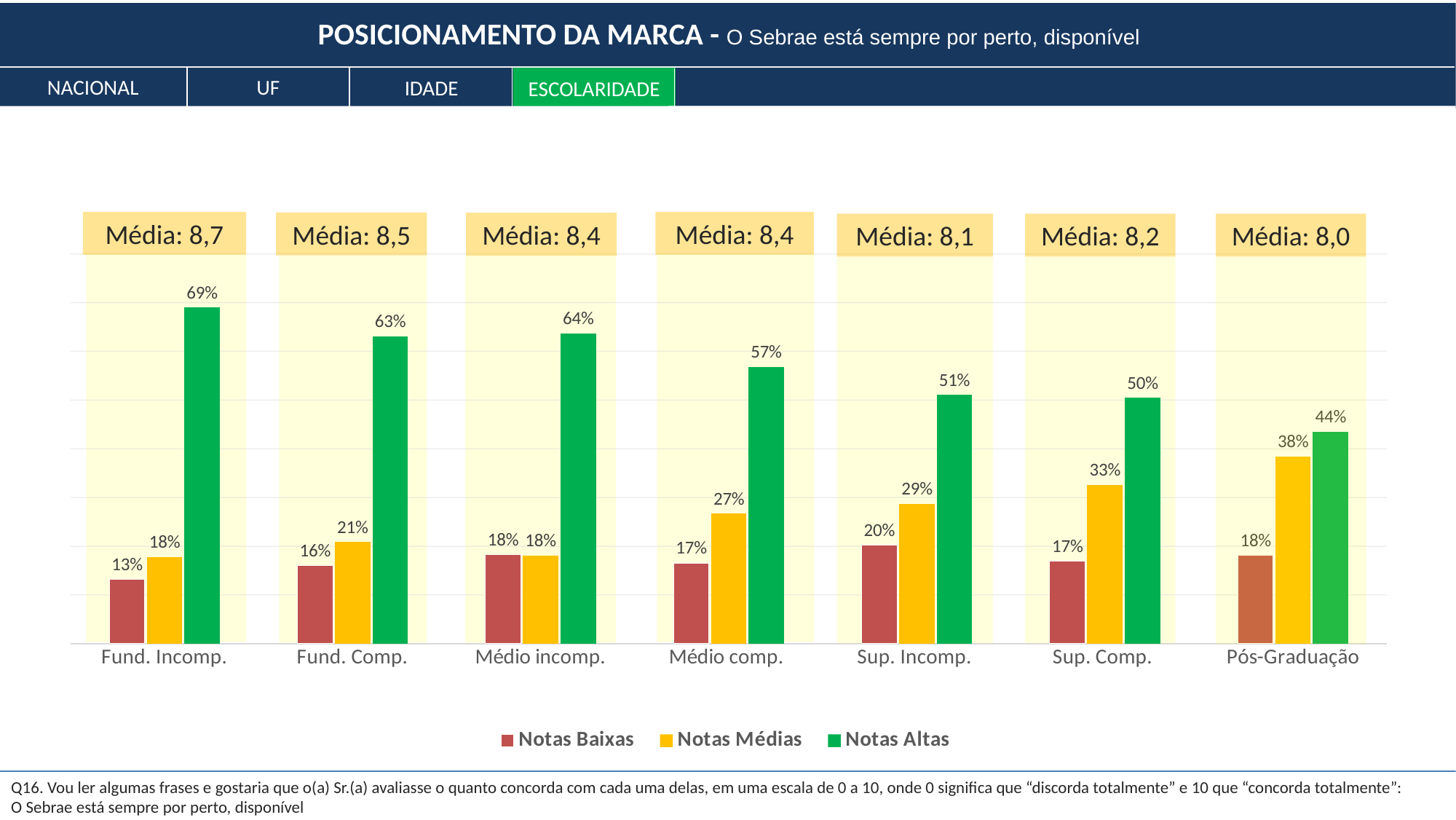
What is the value of Notas Baixas for Sup. Incomp.? 20% How many series does the legend list? 3 What is the Média shown above the Sup. Incomp. category? 8,1 Which category has the highest Notas Altas value? Fund. Incomp. What is the difference between Notas Altas and Notas Baixas for Médio comp.? 40% Do the Notas Médias values generally rise or fall from Fund. Incomp. to Pós-Graduação? Rise What is the value of Notas Médias for Pós-Graduação? 38% What is the value of Notas Altas for Fund. Incomp.? 69% Which is larger for Sup. Comp.: Notas Médias or Notas Baixas? Notas Médias What kind of chart is shown on the slide? Bar chart Which category has the lowest Notas Altas value? Pós-Graduação How many categories are shown on the x axis? 7